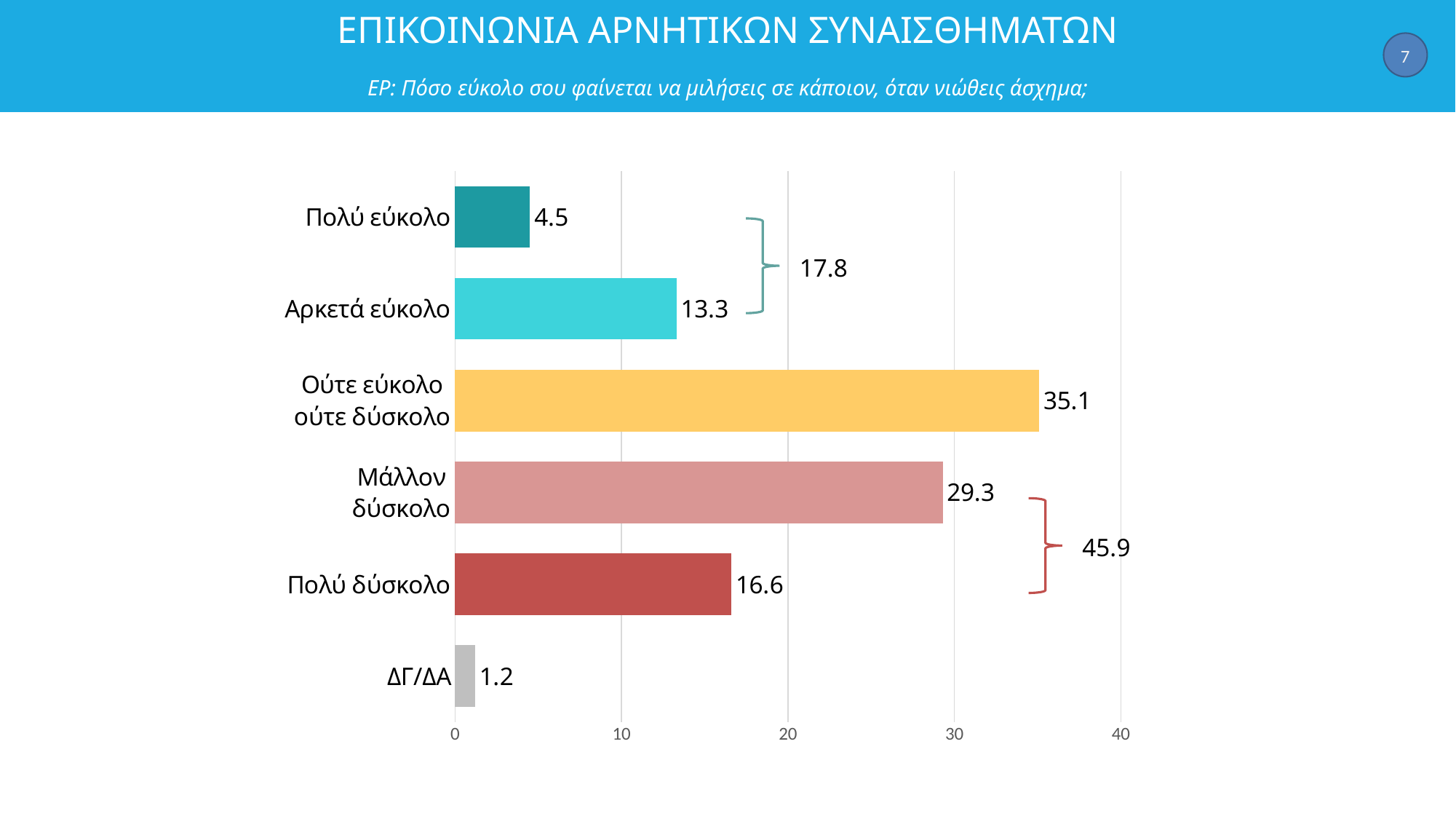
Which category has the lowest value? ΔΓ/ΔΑ What is the value for Ούτε εύκολο ούτε δύσκολο? 35.1 What kind of chart is shown on the slide? bar chart Is the value for Μάλλον δύσκολο greater or less than 20? greater What combined value is shown by the bracket grouping Μάλλον δύσκολο and Πολύ δύσκολο? 45.9 What is the value for Αρκετά εύκολο? 13.3 Which is larger, the value for Αρκετά εύκολο or the value for Πολύ δύσκολο? Πολύ δύσκολο Which category has the highest value? Ούτε εύκολο ούτε δύσκολο What is the value for Πολύ δύσκολο? 16.6 What is the difference between the values for Μάλλον δύσκολο and Πολύ δύσκολο? 12.7 What combined value is shown by the bracket grouping Πολύ εύκολο and Αρκετά εύκολο? 17.8 How many categories are shown in the chart? 6